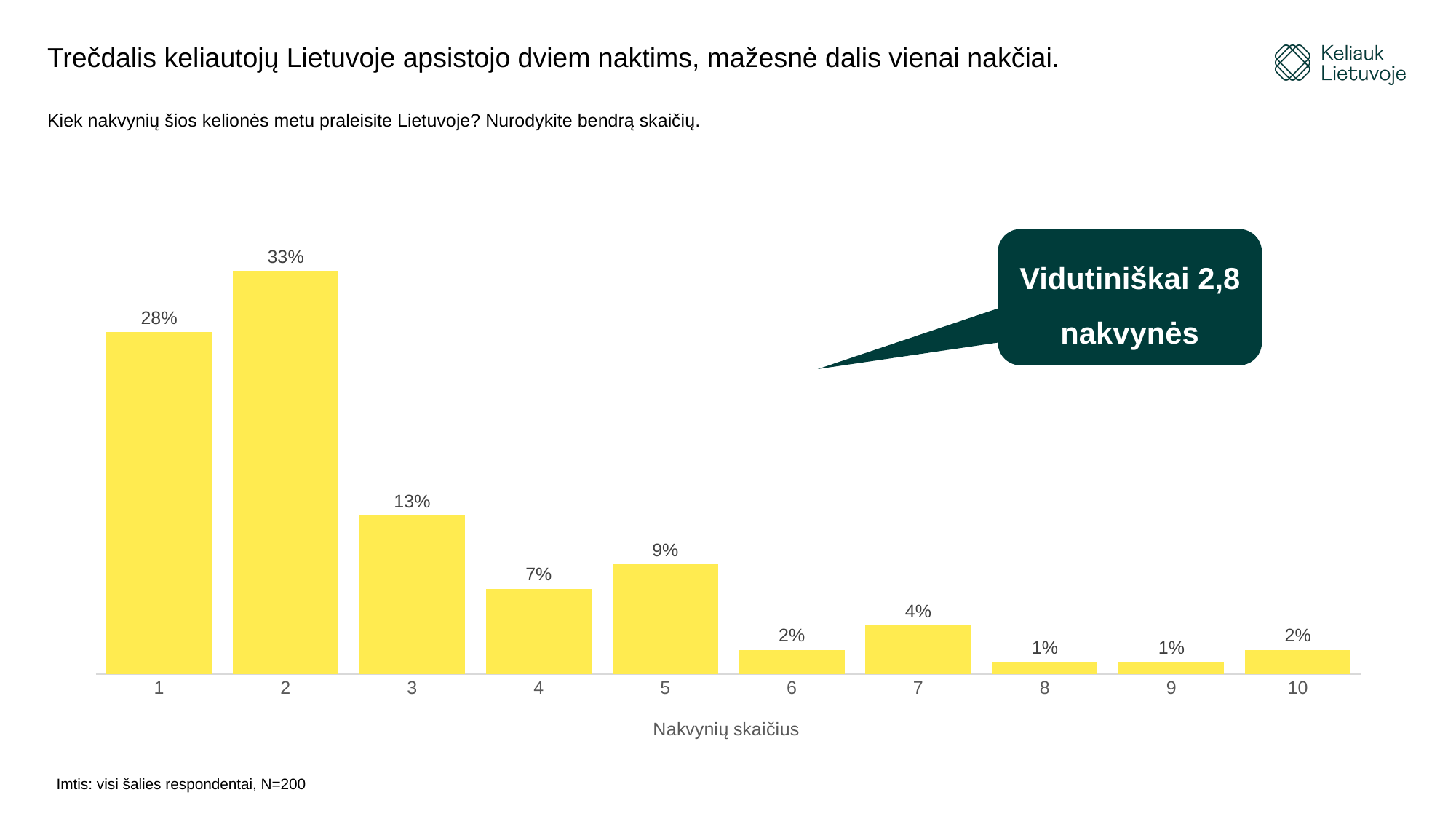
What kind of chart is shown on the slide? Bar chart What percentage of travellers stayed 2 nights? 33% What is the value shown for 5 nights? 9% What is the difference between the values for 3 nights and 4 nights? 6% What average number of nights is stated in the callout on the slide? 2,8 Which number of nights has the highest share of travellers? 2 What percentage is shown for 10 nights? 2% How many categories (numbers of nights) are shown on the x axis? 10 Which is larger, the value for 6 nights or the value for 7 nights? 7 nights Which is larger, the value for 4 nights or the value for 5 nights? 5 nights What is the difference between the values for 1 night and 2 nights? 5% What is the x-axis title of the chart? Nakvynių skaičius